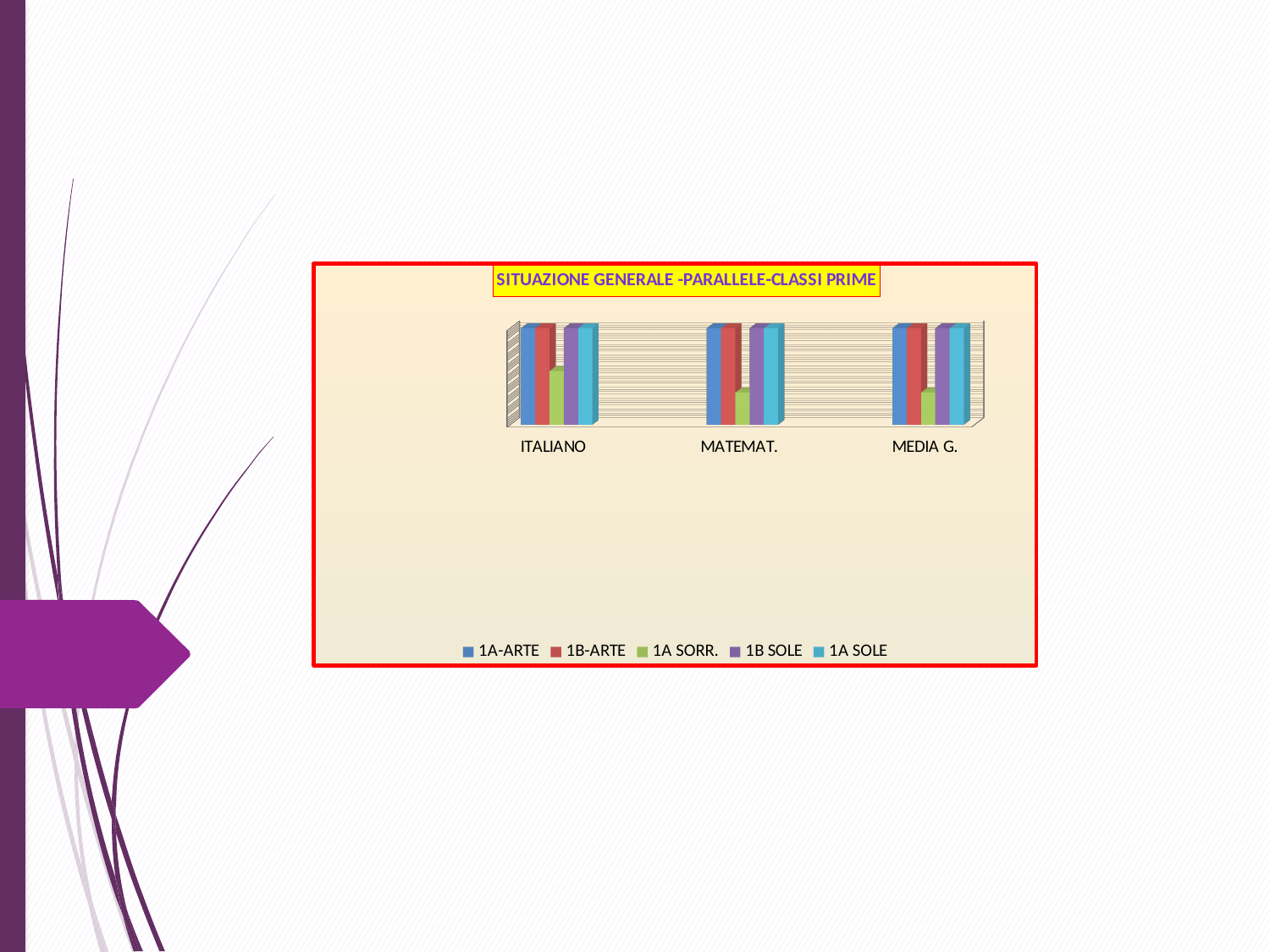
What kind of chart is shown on the slide? bar chart For the 1A SORR. series, which is larger: the value for ITALIANO or the value for MATEMAT.? ITALIANO Which series has the lowest value for MEDIA G.? 1A SORR. Which series has the lowest value for MATEMAT.? 1A SORR. Which series has the lowest value for ITALIANO? 1A SORR. For ITALIANO, which is larger: the value for 1A-ARTE or the value for 1A SORR.? 1A-ARTE How many categories are shown on the x axis of the chart? 3 What is the title of the chart? SITUAZIONE GENERALE -PARALLELE-CLASSI PRIME Which series is shown in green in the chart's legend? 1A SORR. What is the label of the third category on the x axis? MEDIA G. How many series does the chart's legend list? 5 For MEDIA G., which is larger: the value for 1B SOLE or the value for 1A SORR.? 1B SOLE